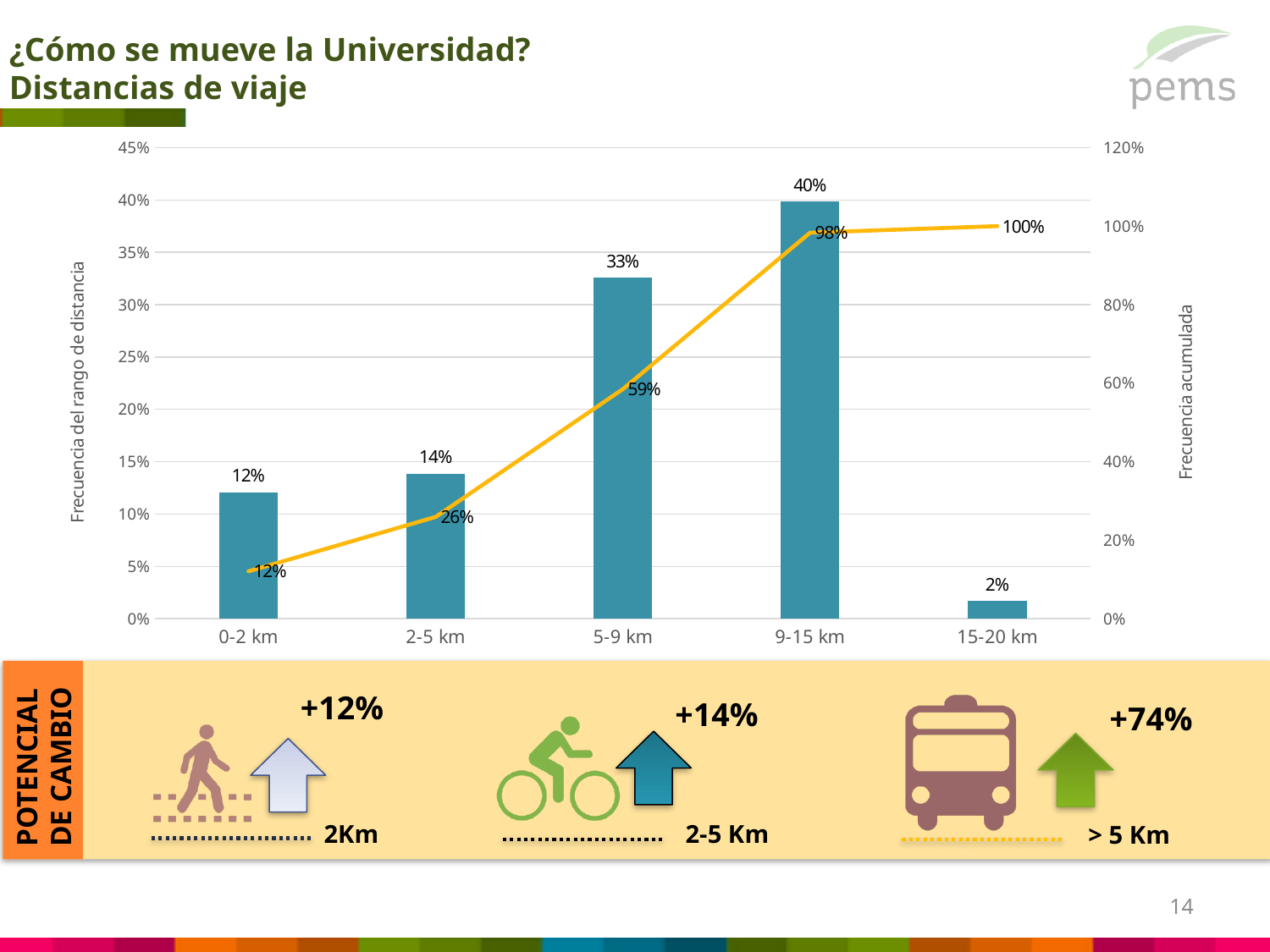
How many distance ranges are shown on the x axis? 5 Which distance range has the highest bar? 9-15 km Does the cumulative frequency line rise or fall from 0-2 km to 15-20 km? Rises Which distance range has the lowest bar? 15-20 km What is the title of the right-hand vertical axis? Frecuencia acumulada What cumulative frequency (line value) is shown at the 9-15 km range? 98% What is the difference between the bar values for 9-15 km and 5-9 km? 7% What is the frequency value shown for the 2-5 km distance range? 14% What kind of chart is shown on the slide? Combined bar and line chart Which bar is larger, 0-2 km or 5-9 km? 5-9 km What is the frequency value shown for the 9-15 km distance range? 40% What cumulative frequency (line value) is shown at the 5-9 km range? 59%